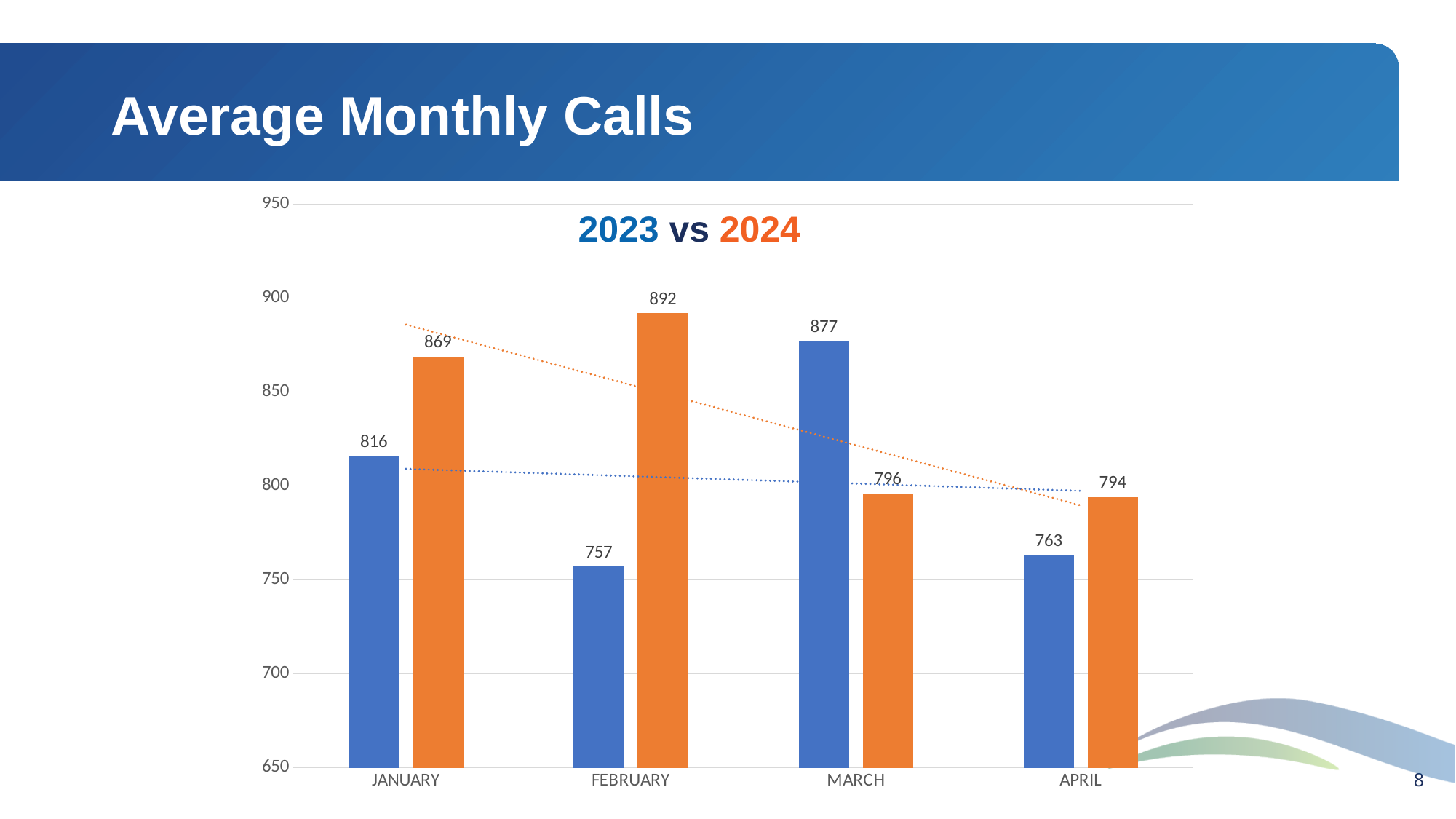
How many series does the chart compare? 2 Which is larger in March, the 2023 value or the 2024 value? 2023 What is the value for 2023 in January? 816 What kind of chart is shown on the slide? Bar chart What is the value for 2023 in March? 877 Which colour represents 2024 in the chart? Orange How many months are shown on the x axis? 4 What is the value for 2024 in April? 794 What is the value for 2024 in February? 892 What is the difference between the 2024 and 2023 values in February? 135 Which month has the lowest value for 2023? February Which month has the highest value for 2024? February